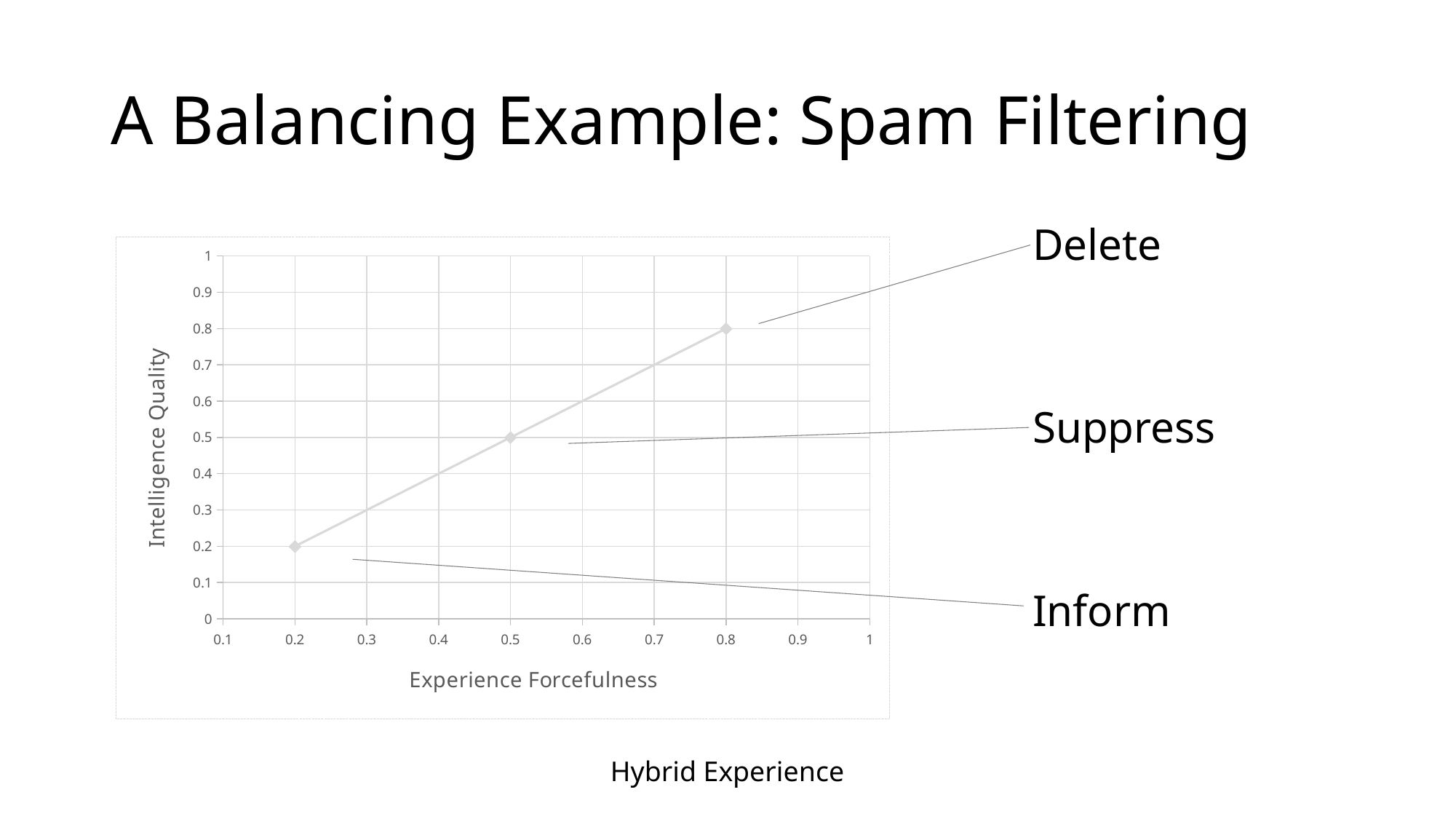
What is the difference in Intelligence Quality between Delete and Inform? 0.6 Which labelled point has the highest Intelligence Quality? Delete What kind of chart is shown on the slide? line chart Is the Intelligence Quality of the Delete point greater or less than 0.7? greater What is the Intelligence Quality value of the point labelled Delete? 0.8 Which has a higher Experience Forcefulness, Suppress or Inform? Suppress How many data points are plotted on the chart? 3 Which labelled point has the lowest Experience Forcefulness? Inform What is the Intelligence Quality value of the point labelled Suppress? 0.5 What is the title of the horizontal axis? Experience Forcefulness Does Intelligence Quality rise or fall as Experience Forcefulness increases? rise What is the Experience Forcefulness value of the point labelled Inform? 0.2